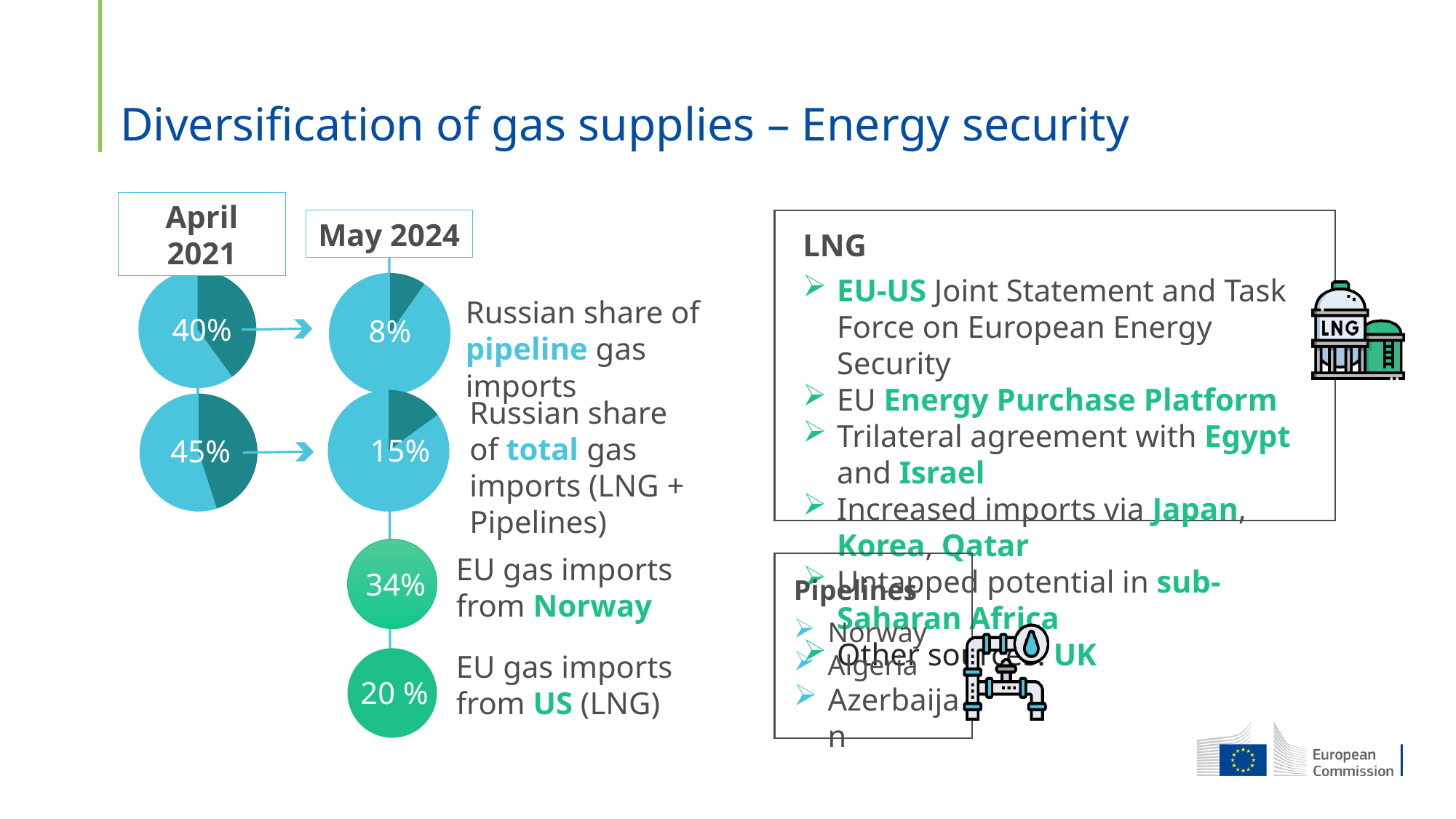
In April 2021, which was larger: the Russian share of pipeline gas imports or the Russian share of total gas imports? Russian share of total gas imports (45%) In the pie chart for May 2024, what is the Russian share of total gas imports (LNG + Pipelines)? 15% What kind of chart is used to show the Russian share of gas imports? pie chart Does the Russian share of pipeline gas imports rise or fall from April 2021 to May 2024? fall By how many percentage points did the Russian share of pipeline gas imports fall between April 2021 and May 2024? 32 percentage points According to the green circle on the slide, what share of EU gas imports comes from Norway? 34% In the pie chart for April 2021, what is the Russian share of pipeline gas imports? 40% In the pie chart for May 2024, what is the Russian share of pipeline gas imports? 8% How many pie charts are shown on the slide? 4 By how many percentage points did the Russian share of total gas imports fall between April 2021 and May 2024? 30 percentage points In the pie chart for April 2021, what is the Russian share of total gas imports (LNG + Pipelines)? 45% According to the green circle on the slide, what share of EU gas imports comes from the US (LNG)? 20 %